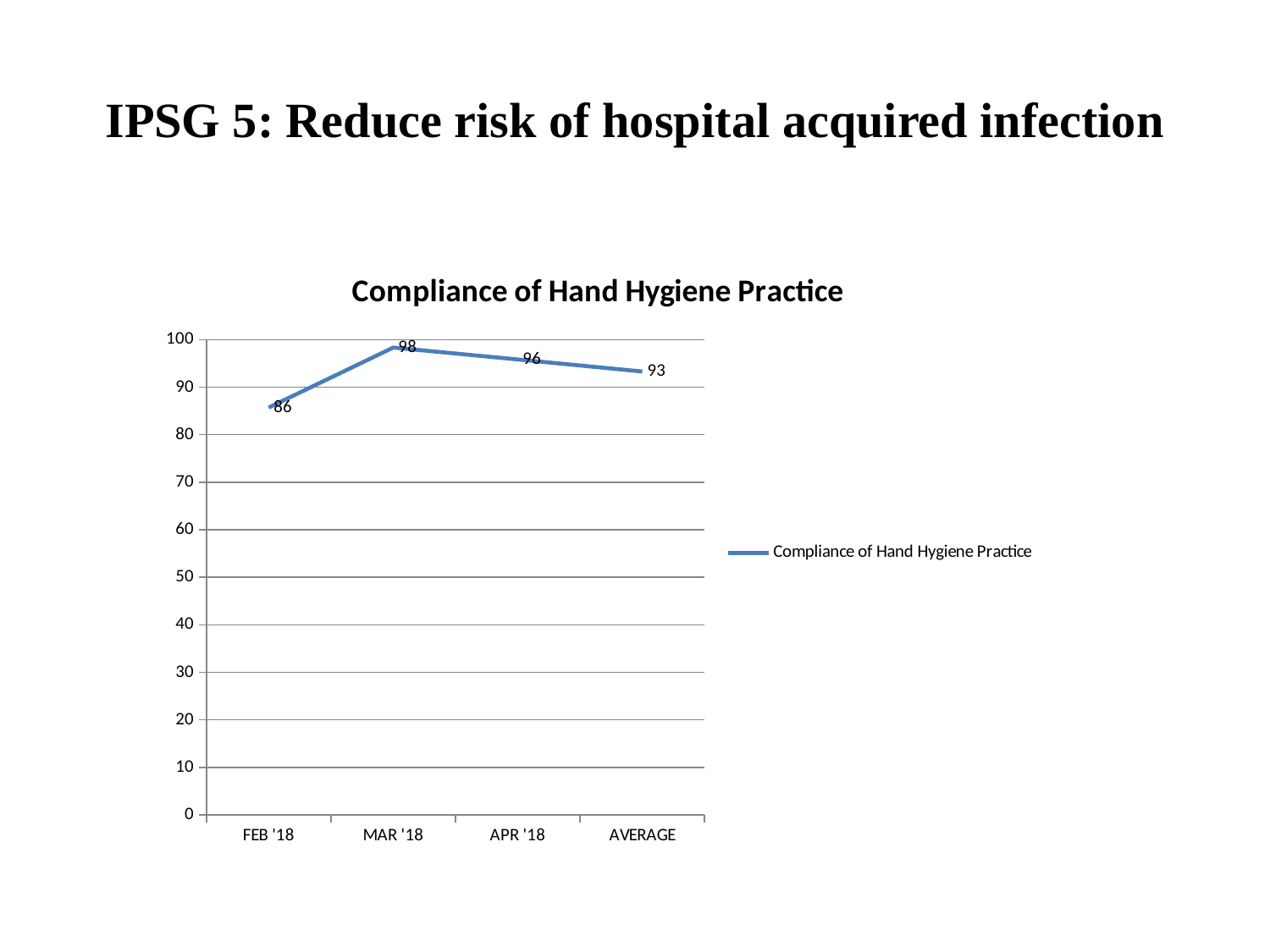
What kind of chart is shown? line chart What is the value for APR '18? 96 How many categories are shown on the x axis? 4 What is the difference between the values for MAR '18 and FEB '18? 12 Which category has the highest value? MAR '18 What is the value for FEB '18? 86 Which category has the lowest value? FEB '18 Which is larger, the value for APR '18 or the value for AVERAGE? APR '18 What is the value for AVERAGE? 93 Is the value for FEB '18 greater or less than 90? less What is the value for MAR '18? 98 What is the title of the chart? Compliance of Hand Hygiene Practice